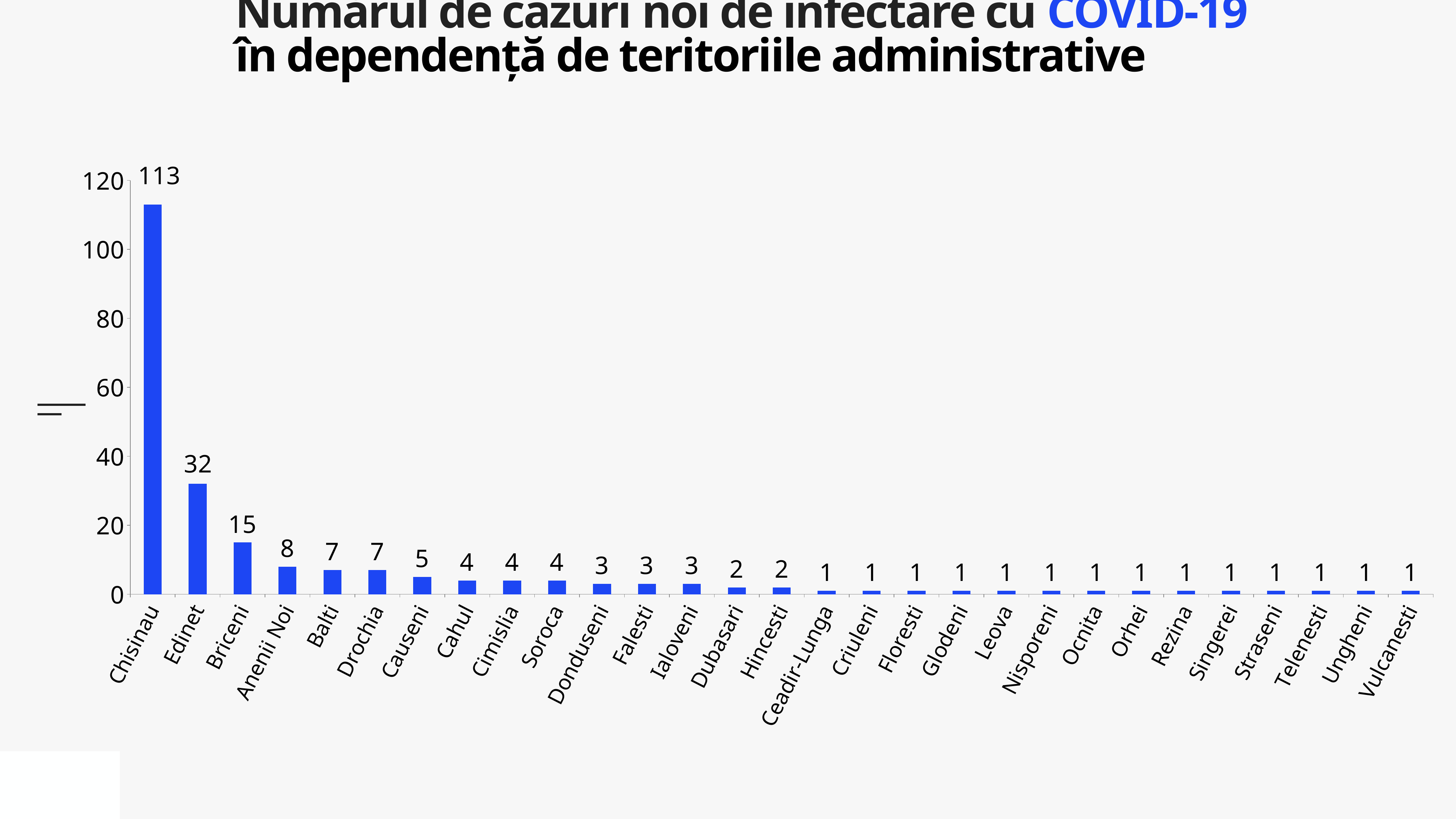
How many categories are shown on the x axis? 29 What is the value for Anenii Noi? 8 Which is larger, the value for Edinet or the value for Briceni? Edinet Which category has the highest value? Chisinau What is the value for Briceni? 15 What is the value for Chisinau? 113 What is the value for Causeni? 5 Is the value for Chisinau greater or less than 100? greater What is the difference between the values for Chisinau and Edinet? 81 What kind of chart is shown on the slide? bar chart What is the value for Edinet? 32 What is the difference between the values for Briceni and Anenii Noi? 7